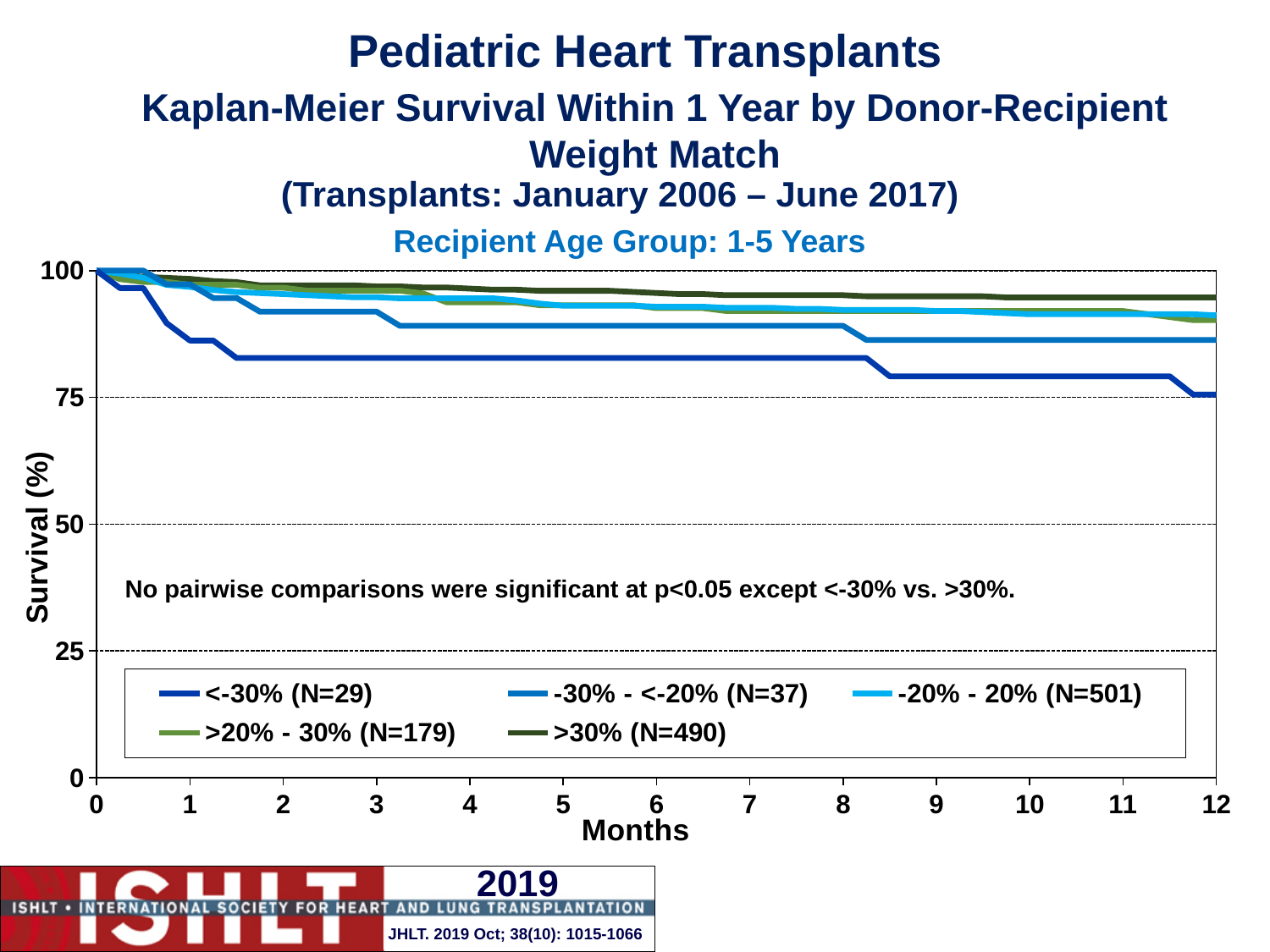
At 12 months, which group has higher survival: <-30% or -30% - <-20%? -30% - <-20% Which recipient age group does the chart cover? 1-5 Years At 6 months, which group has higher survival: <-30% or >30%? >30% What is the N shown in the legend for the -20% - 20% group? 501 Do the survival curves rise or fall as months increase along the x axis? fall Is the survival value for the -30% - <-20% group at 12 months greater or less than 75? greater What is the label on the y axis? Survival (%) How many series does the legend list? 5 What kind of chart is shown on the slide? line chart Is the survival value for the >30% group at 12 months greater or less than 75? greater Which weight-match group has the lowest survival at 12 months? <-30% (N=29) Is the survival value for the <-30% group at 6 months greater or less than 75? greater